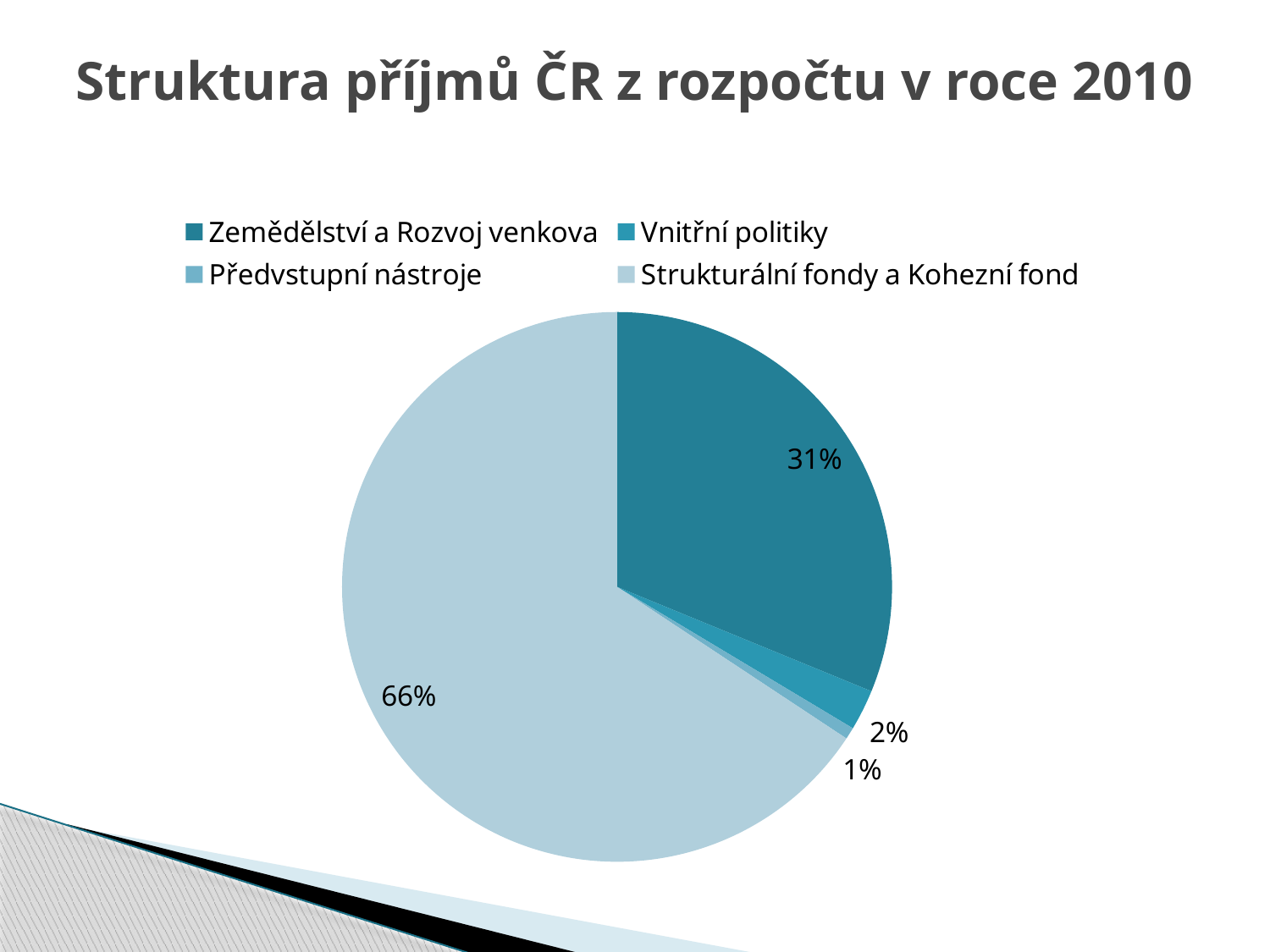
What share of the pie does Předvstupní nástroje represent? 1% Which category has the largest slice of the pie? Strukturální fondy a Kohezní fond How many categories does the pie chart show? 4 What share of the pie does Vnitřní politiky represent? 2% What is the title of the chart on the slide? Struktura příjmů ČR z rozpočtu v roce 2010 What kind of chart is shown on the slide? pie chart What is the difference in percentage points between Strukturální fondy a Kohezní fond and Zemědělství a Rozvoj venkova? 35 percentage points What share of the pie does Zemědělství a Rozvoj venkova represent? 31% Which legend entry is listed first in the chart's legend? Zemědělství a Rozvoj venkova Which category has the smallest slice of the pie? Předvstupní nástroje Which is larger, the share for Vnitřní politiky or the share for Předvstupní nástroje? Vnitřní politiky